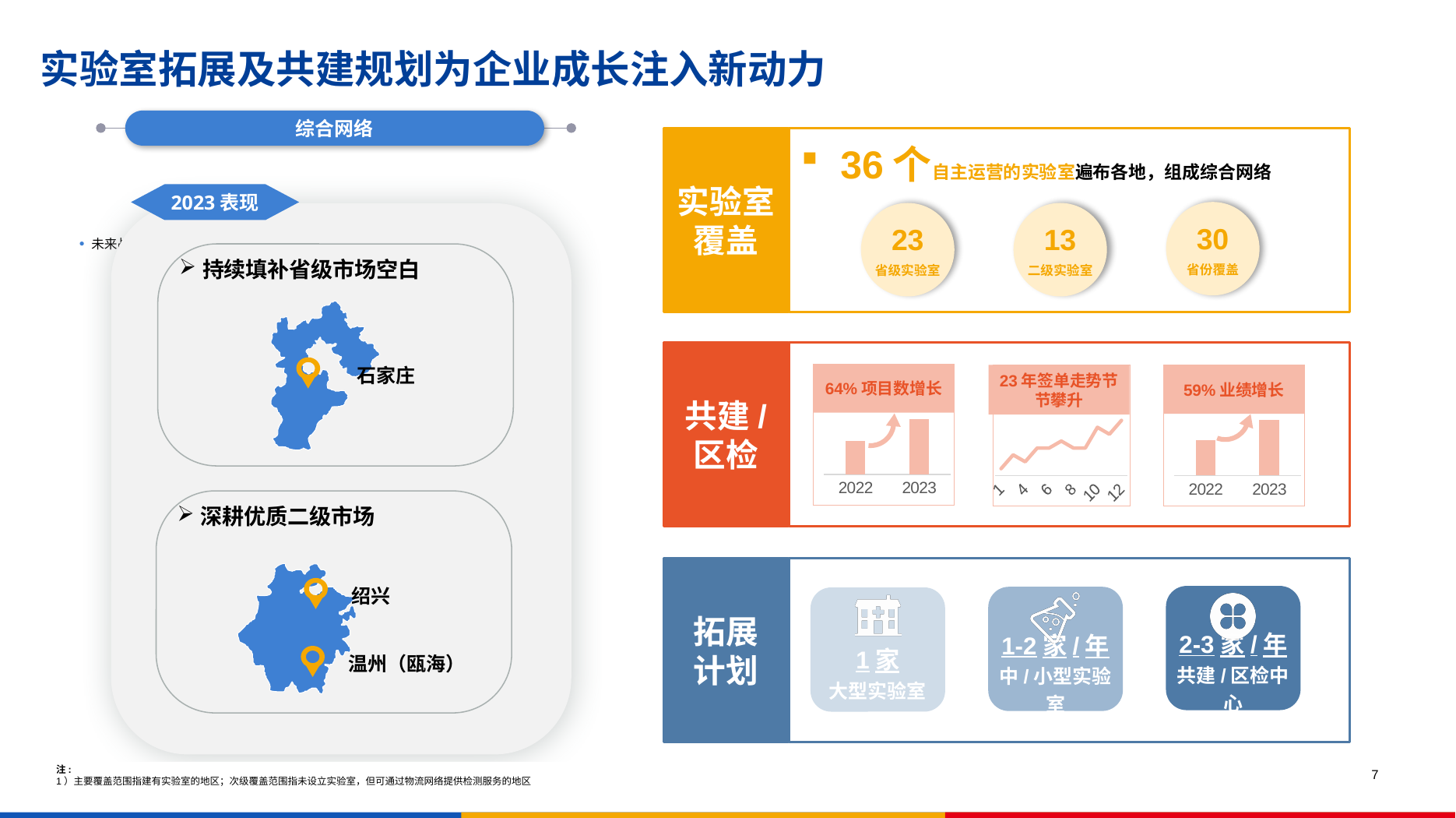
In the chart titled "59% 业绩增长", which year has the higher bar, 2022 or 2023? 2023 In the chart titled "23 年签单走势节节攀升", what kind of chart is it? line chart In the chart titled "23 年签单走势节节攀升", how many tick labels are shown on the x axis? 6 In the chart titled "64% 项目数增长", what kind of chart is it? bar chart In the chart titled "59% 业绩增长", what kind of chart is it? bar chart In the chart titled "59% 业绩增长", which category has the lowest bar? 2022 In the chart titled "64% 项目数增长", which year has the taller bar, 2022 or 2023? 2023 How many charts are shown in the "共建 / 区检" section of the slide? 3 In the chart titled "64% 项目数增长", do the values rise or fall from 2022 to 2023? rise In the chart titled "23 年签单走势节节攀升", what is the overall trend of the line from left to right? rising In the chart titled "23 年签单走势节节攀升", what is the last tick label on the x axis? 12 In the chart titled "64% 项目数增长", how many categories are shown on the x axis? 2